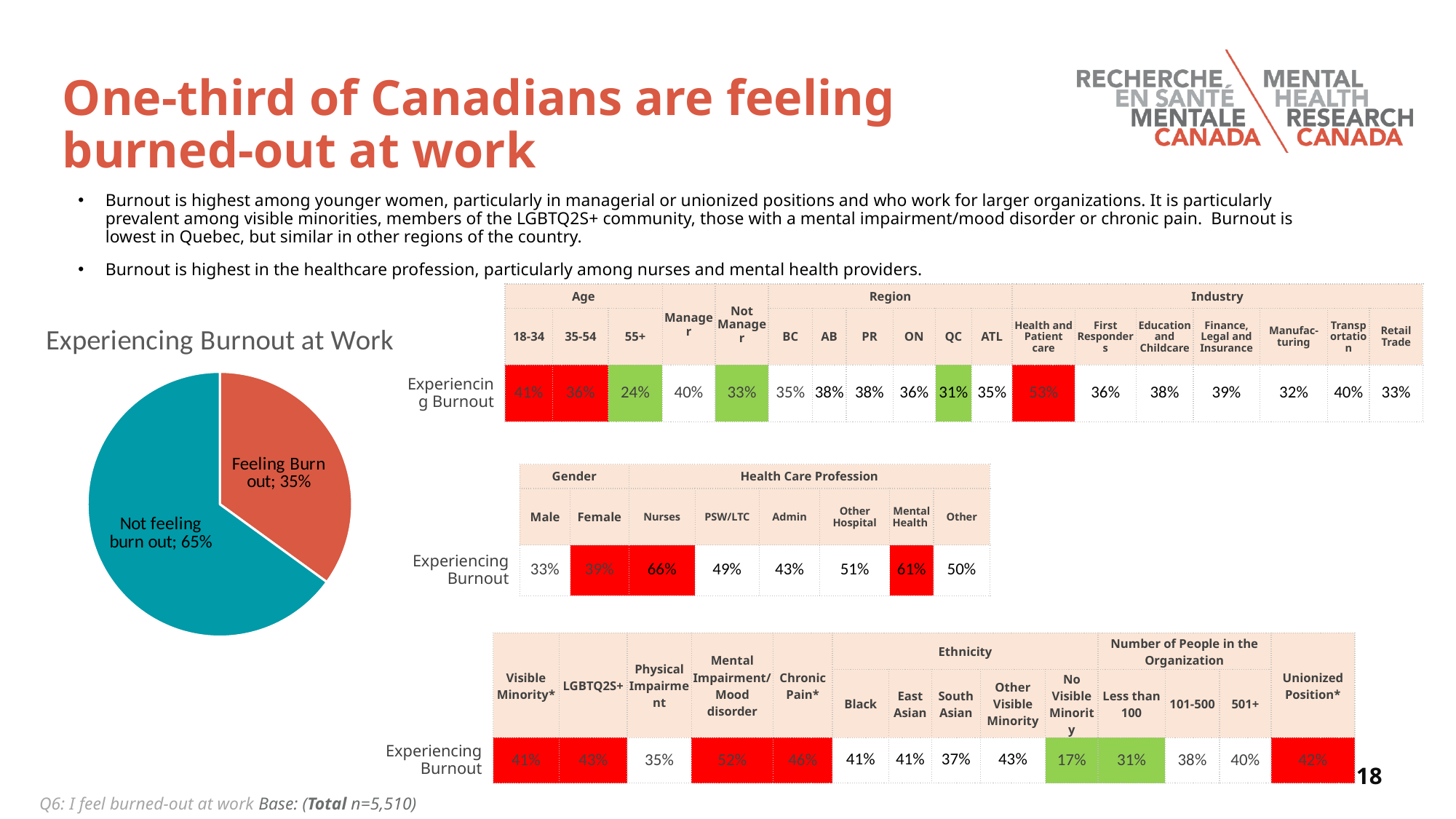
What share of the pie does the "Feeling Burn out" slice represent? 35% What colour is the "Not feeling burn out" slice in the pie chart? Teal In the pie chart, which is larger: "Feeling Burn out" or "Not feeling burn out"? Not feeling burn out What kind of chart is "Experiencing Burnout at Work"? Pie chart In the pie chart, how many percentage points larger is "Not feeling burn out" than "Feeling Burn out"? 30 percentage points What is the title of the pie chart on the slide? Experiencing Burnout at Work Which slice of the pie chart is the largest? Not feeling burn out How many slices does the pie chart have? 2 In the pie chart, what percentage of respondents are "Feeling Burn out"? 35% In the pie chart, what percentage of respondents are "Not feeling burn out"? 65% Which slice of the pie chart is the smallest? Feeling Burn out